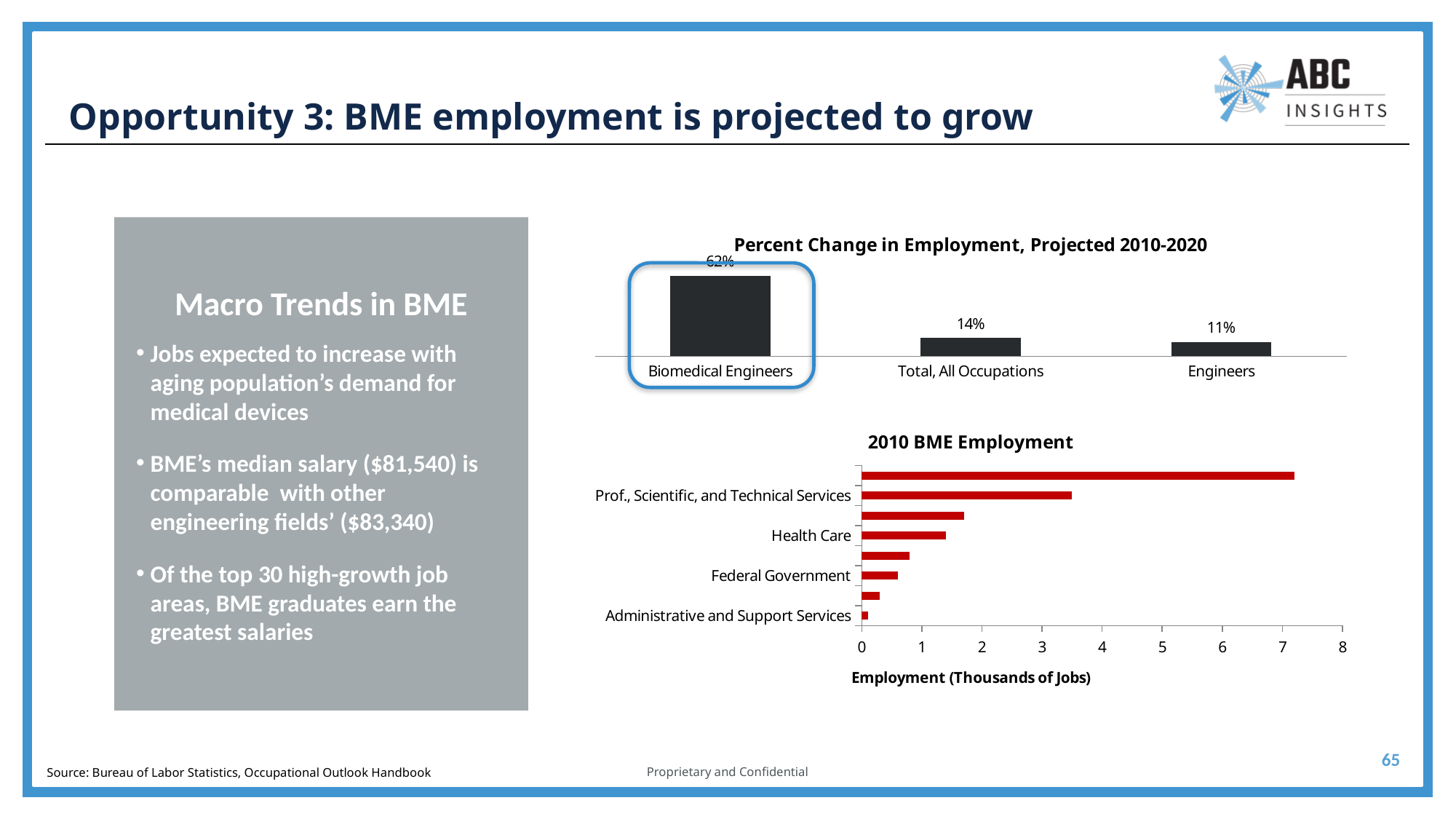
In the 'Percent Change in Employment, Projected 2010-2020' chart, what is the difference between Biomedical Engineers and Total, All Occupations? 48 percentage points In the '2010 BME Employment' chart, which is larger, Federal Government or Health Care? Health Care In the 'Percent Change in Employment, Projected 2010-2020' chart, which category has the lowest value? Engineers What is the x-axis title of the '2010 BME Employment' chart? Employment (Thousands of Jobs) What kind of chart is the '2010 BME Employment' chart? Bar chart In the 'Percent Change in Employment, Projected 2010-2020' chart, which category has the highest value? Biomedical Engineers In the 'Percent Change in Employment, Projected 2010-2020' chart, what is the value for Engineers? 11% In the '2010 BME Employment' chart, is the value for Prof., Scientific, and Technical Services greater or less than 3? greater In the 'Percent Change in Employment, Projected 2010-2020' chart, what is the value for Biomedical Engineers? 62% In the 'Percent Change in Employment, Projected 2010-2020' chart, how many categories are shown? 3 In the '2010 BME Employment' chart, is the value for Health Care greater or less than 2? less In the 'Percent Change in Employment, Projected 2010-2020' chart, what is the value for Total, All Occupations? 14%